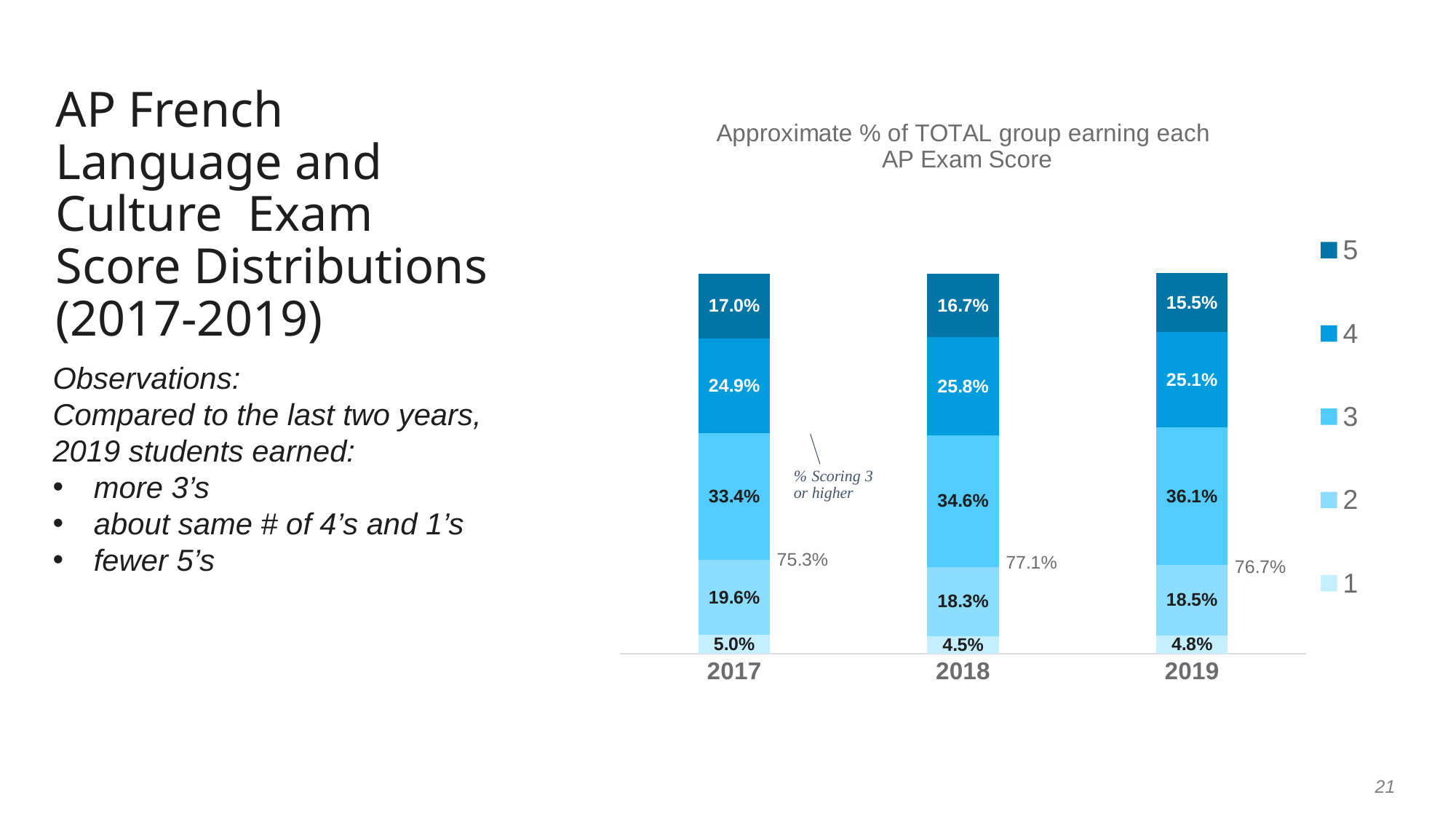
What percentage of the 2018 group earned a score of 1? 4.5% By how many percentage points did the share of students scoring 3 increase from 2017 to 2019? 2.7 percentage points Which year has the lowest percentage of students earning a score of 5? 2019 Does the percentage of students earning a score of 5 rise or fall from 2017 to 2019? Fall What kind of chart is shown on the slide? Stacked bar chart How many years are shown on the x axis of the chart? 3 What percentage of the 2017 group earned a score of 5? 17.0% Which year has the highest percentage of students earning a score of 3? 2019 What percentage of the 2019 group earned a score of 3? 36.1% Which year had a larger share of students scoring 2: 2017 or 2018? 2017 How many series does the chart legend list? 5 What is the percentage scoring 3 or higher shown for 2018? 77.1%